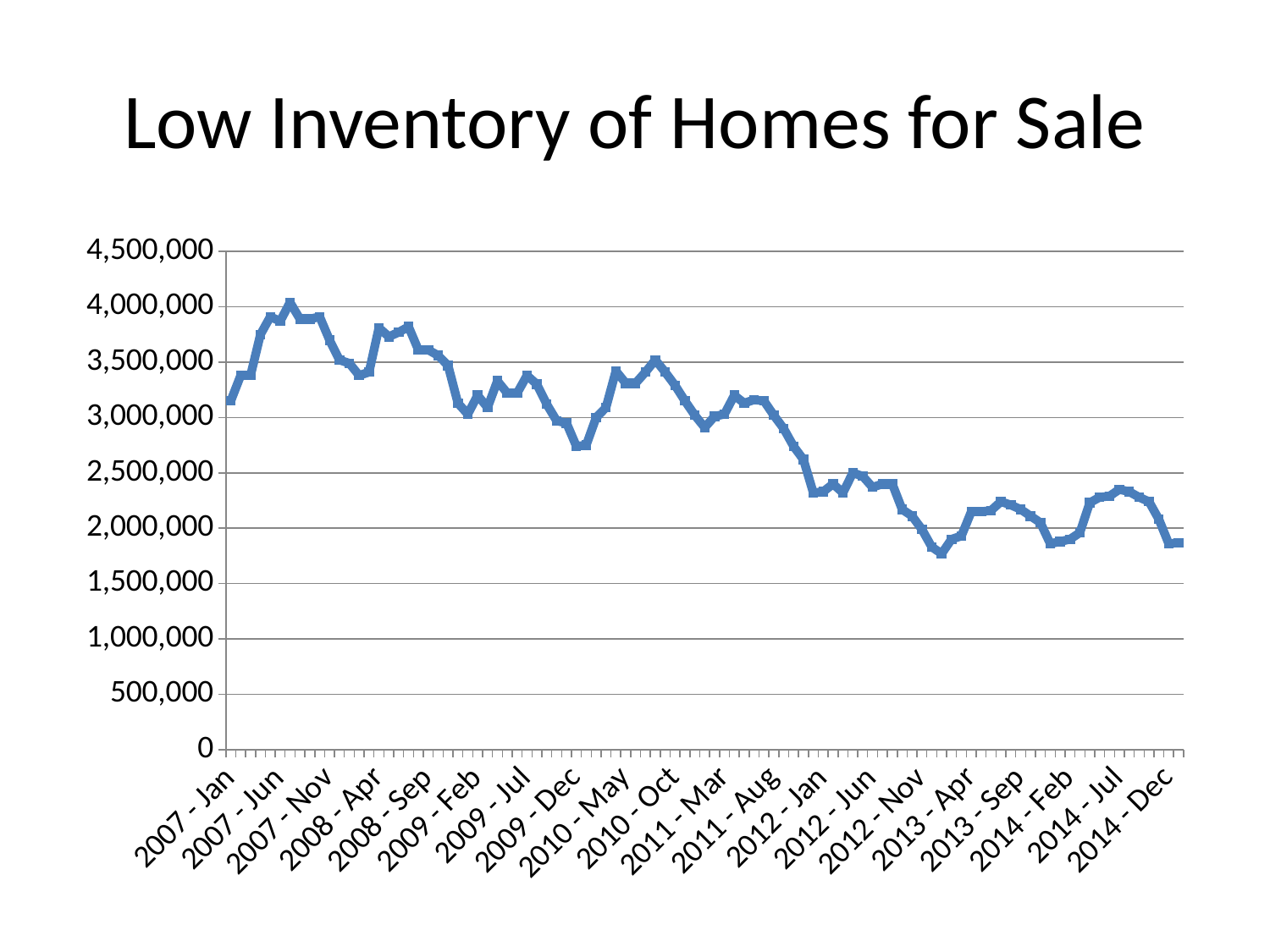
Overall, do the values rise or fall from 2007 - Jan to 2014 - Dec? fall Is the value for 2007 - Jun greater or less than 3,500,000? greater What is the title of the chart? Low Inventory of Homes for Sale What kind of chart is shown on the slide? line chart Which is larger, the value for 2007 - Jan or the value for 2014 - Dec? 2007 - Jan Is the value for 2012 - Jan greater or less than 3,000,000? less Is the value for 2009 - Dec greater or less than 3,000,000? less How many labels are shown on the x axis? 20 Which is larger, the value for 2007 - Jun or the value for 2012 - Jun? 2007 - Jun